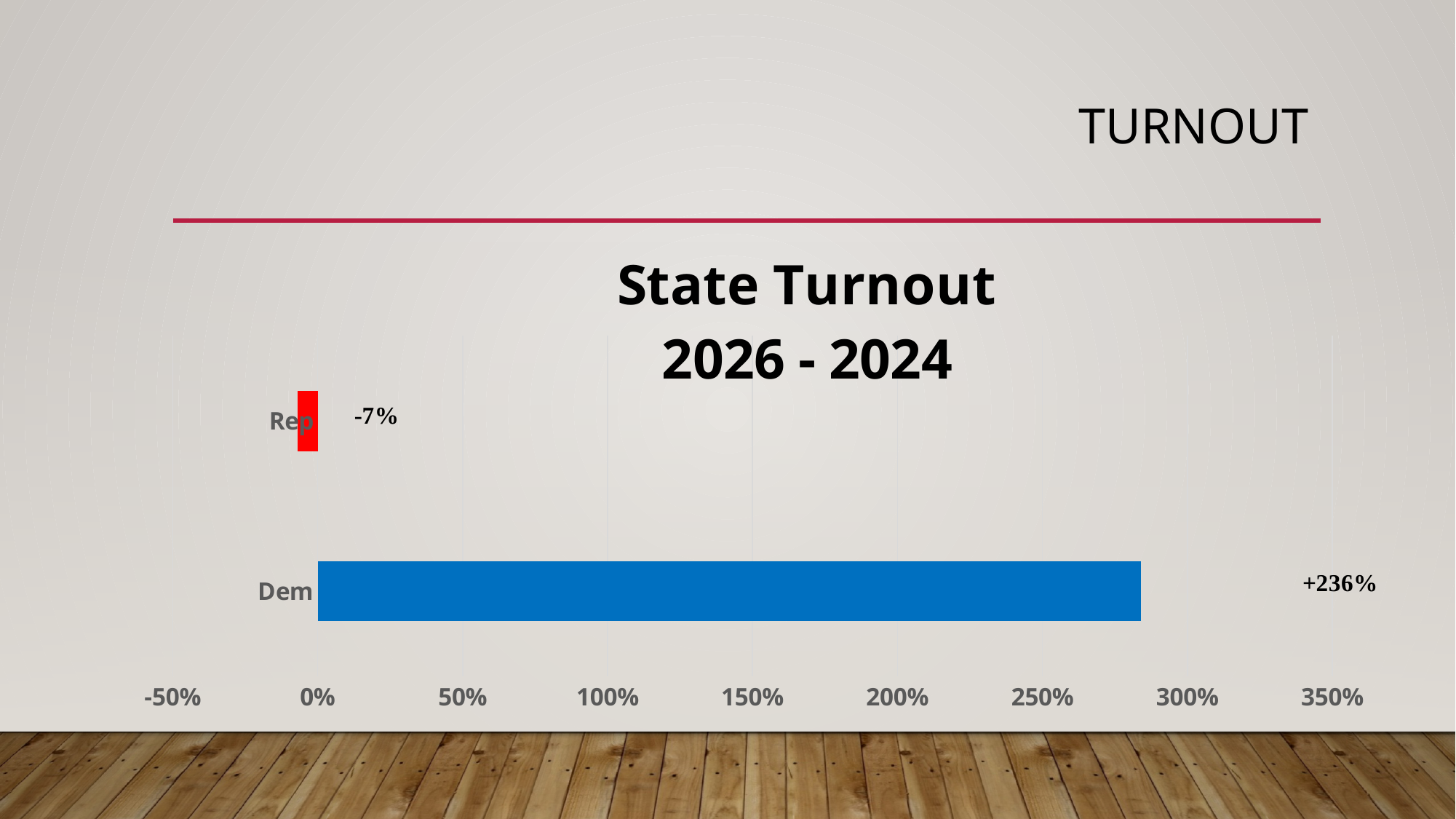
What is the value shown for Dem? +236% How many categories are shown in the chart? 2 Is the value for Dem greater or less than 200%? greater What is the difference between the Dem value and the Rep value? 243 percentage points What is the title of the chart? State Turnout 2026 - 2024 Which category has the lowest value? Rep What kind of chart is shown on the slide? bar chart What colour is the Dem bar? blue Which is larger, the value for Dem or the value for Rep? Dem Is the value for Rep greater or less than 0%? less Which category has the highest value? Dem What is the value shown for Rep? -7%